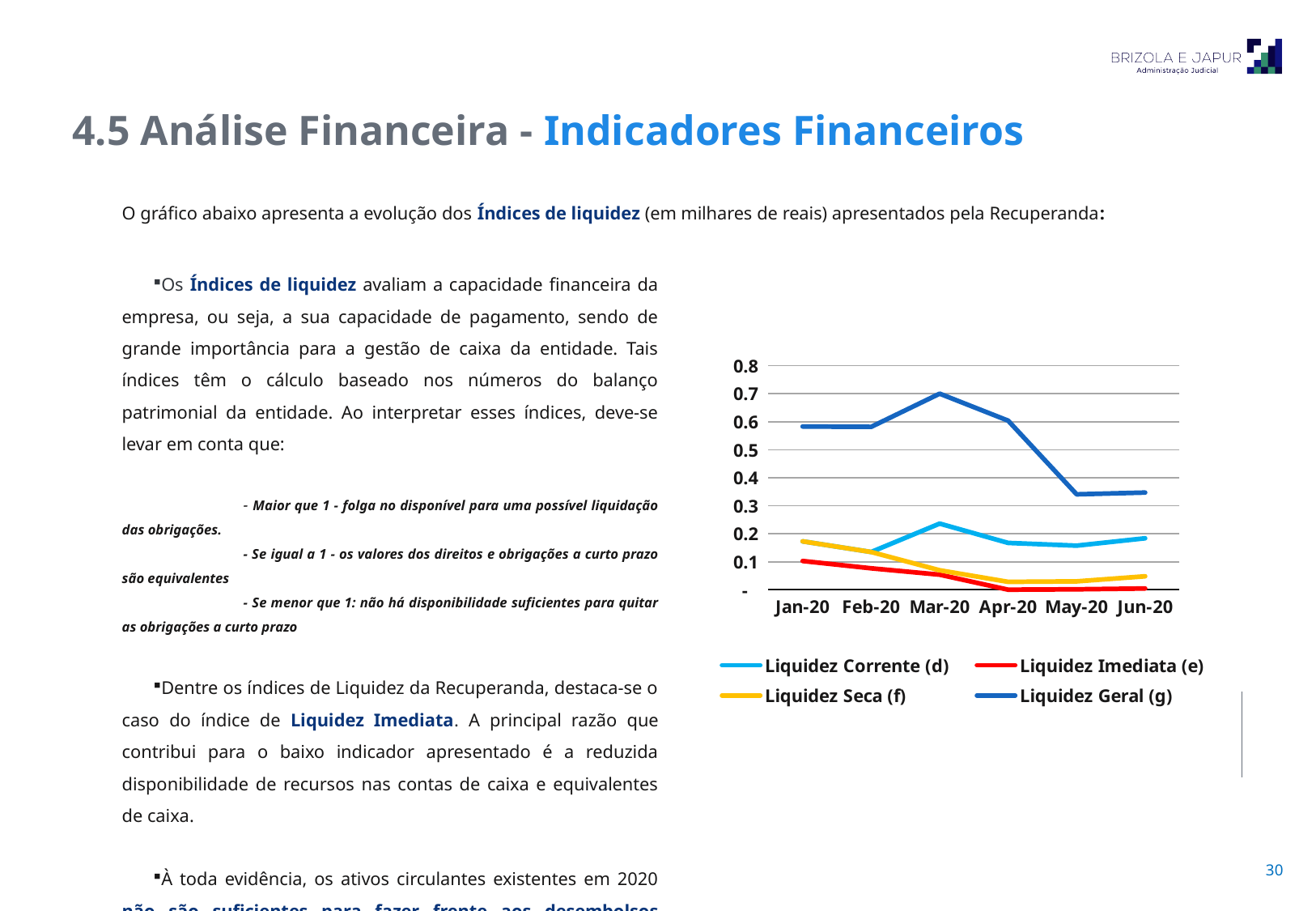
What kind of chart is shown on the slide? line chart In which month does Liquidez Corrente (d) reach its highest value? Mar-20 Which series has the higher value in Jun-20, Liquidez Geral (g) or Liquidez Corrente (d)? Liquidez Geral (g) Which series is drawn in red in the chart? Liquidez Imediata (e) Is the value of Liquidez Geral (g) in Jun-20 greater or less than 0.4? less Does Liquidez Seca (f) generally rise or fall from Jan-20 to May-20? fall In which month does Liquidez Geral (g) reach its highest value? Mar-20 How many months are plotted along the x axis of the chart? 6 Is the value of Liquidez Imediata (e) in Jan-20 greater or less than 0.2? less Is the value of Liquidez Geral (g) in Mar-20 greater or less than 0.6? greater How many series does the chart legend list? 4